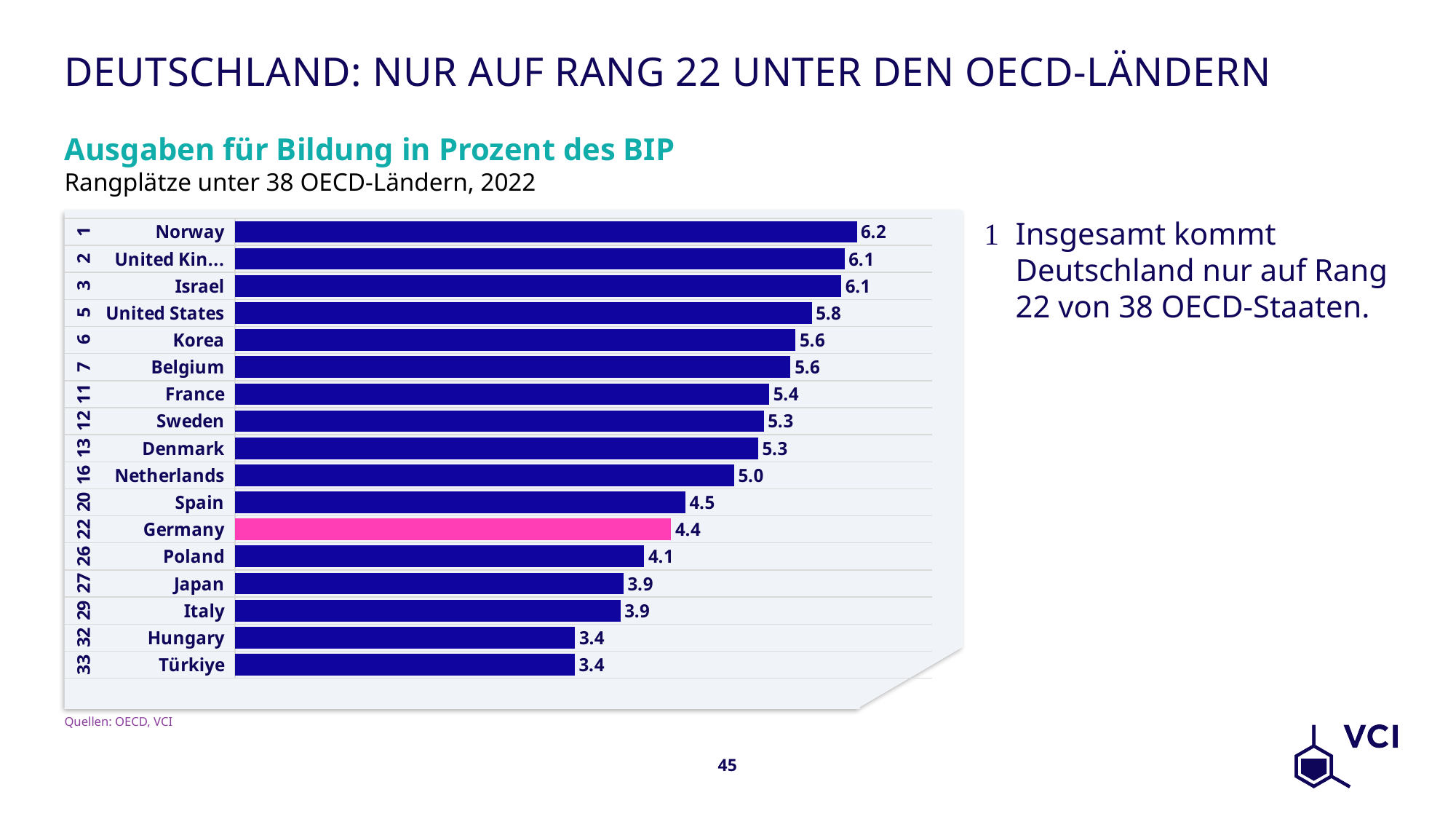
How many countries are shown in the chart? 17 What rank number is shown next to Germany? 22 Which country has the highest value? Norway What is the difference between the values for Norway and Germany? 1.8 What is the value for Norway? 6.2 What is the value for Germany? 4.4 What is the difference between the values for United States and Poland? 1.7 Which is larger, the value for Spain or the value for Japan? Spain What is the value for Netherlands? 5.0 Which is larger, the value for France or the value for Italy? France What kind of chart is shown on the slide? Bar chart Which country's bar is highlighted in pink? Germany